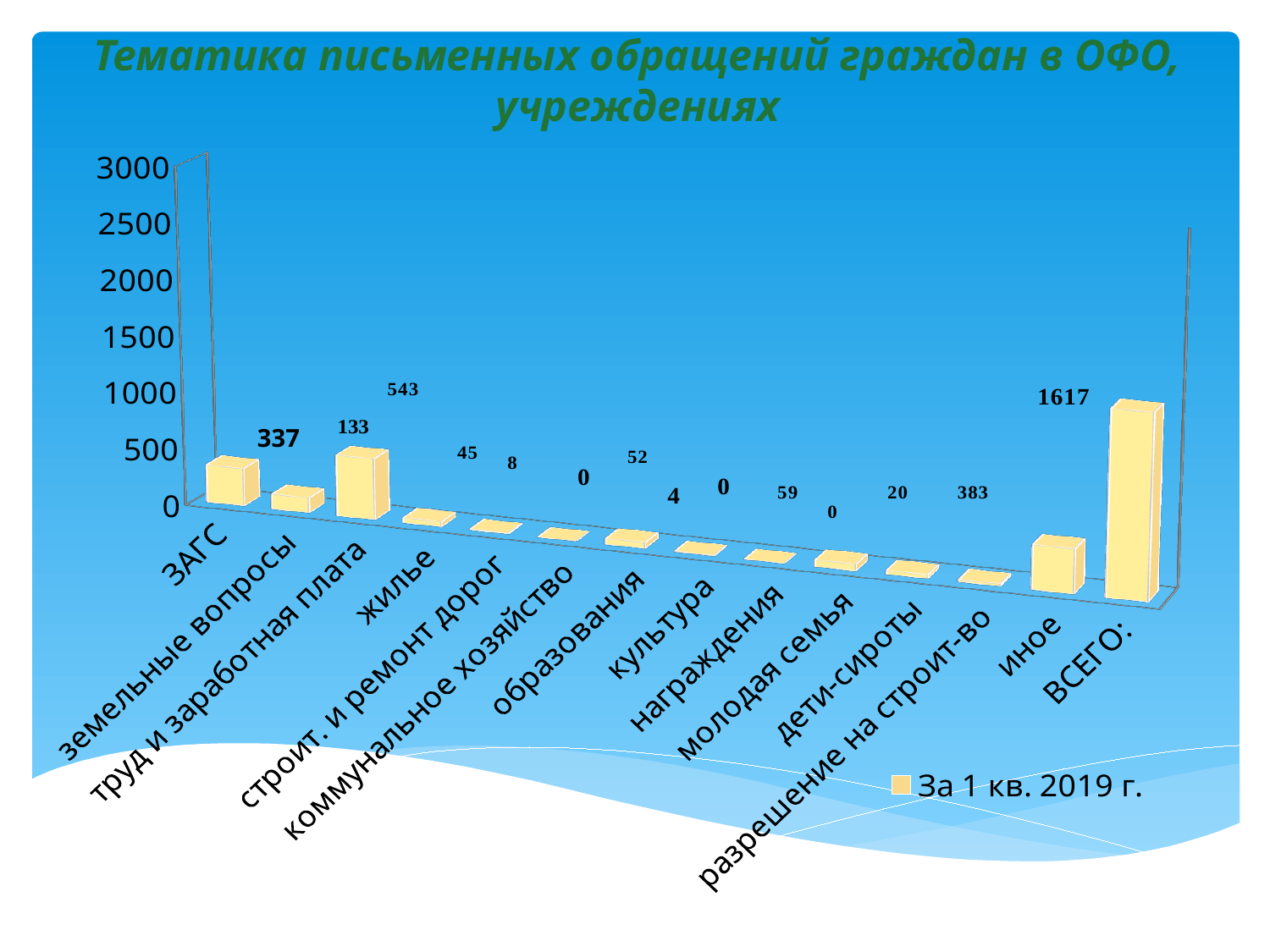
What type of chart is shown on the slide? bar chart What is the value for иное? 383 What is the value for ВСЕГО:? 1617 What series name does the legend show? За 1 кв. 2019 г. Excluding ВСЕГО:, which category has the highest value? труд и заработная плата What is the difference between the values for труд и заработная плата and ЗАГС? 206 Which is larger, the value for иное or the value for ЗАГС? иное What is the value for земельные вопросы? 133 How many categories are shown on the x axis? 14 What is the value for ЗАГС? 337 Which category has the highest value? ВСЕГО: What is the value for труд и заработная плата? 543